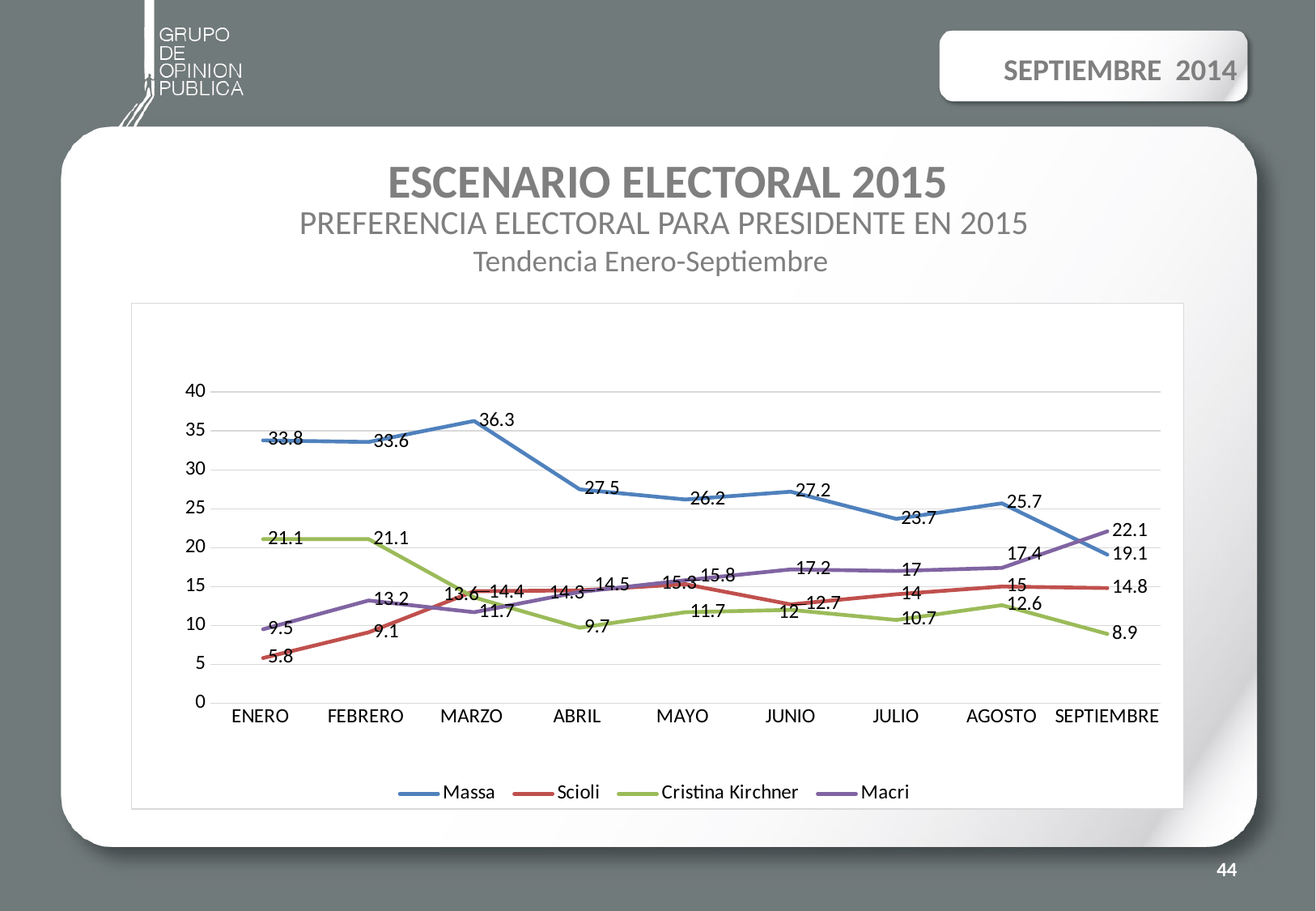
How many months are shown on the x axis? 9 What is the value for Macri in SEPTIEMBRE? 22.1 How many series does the legend list? 4 What is the value for Scioli in ENERO? 5.8 What is the difference between Massa's value in ENERO and in SEPTIEMBRE? 14.7 What kind of chart is shown on the slide? Line chart Does the Macri line generally rise or fall from ENERO to SEPTIEMBRE? Rise In which month does Massa reach its highest value? MARZO What is the value for Massa in MARZO? 36.3 In which month does Cristina Kirchner have her lowest value? SEPTIEMBRE In SEPTIEMBRE, which is larger: the value for Macri or the value for Massa? Macri What is the value for Cristina Kirchner in SEPTIEMBRE? 8.9